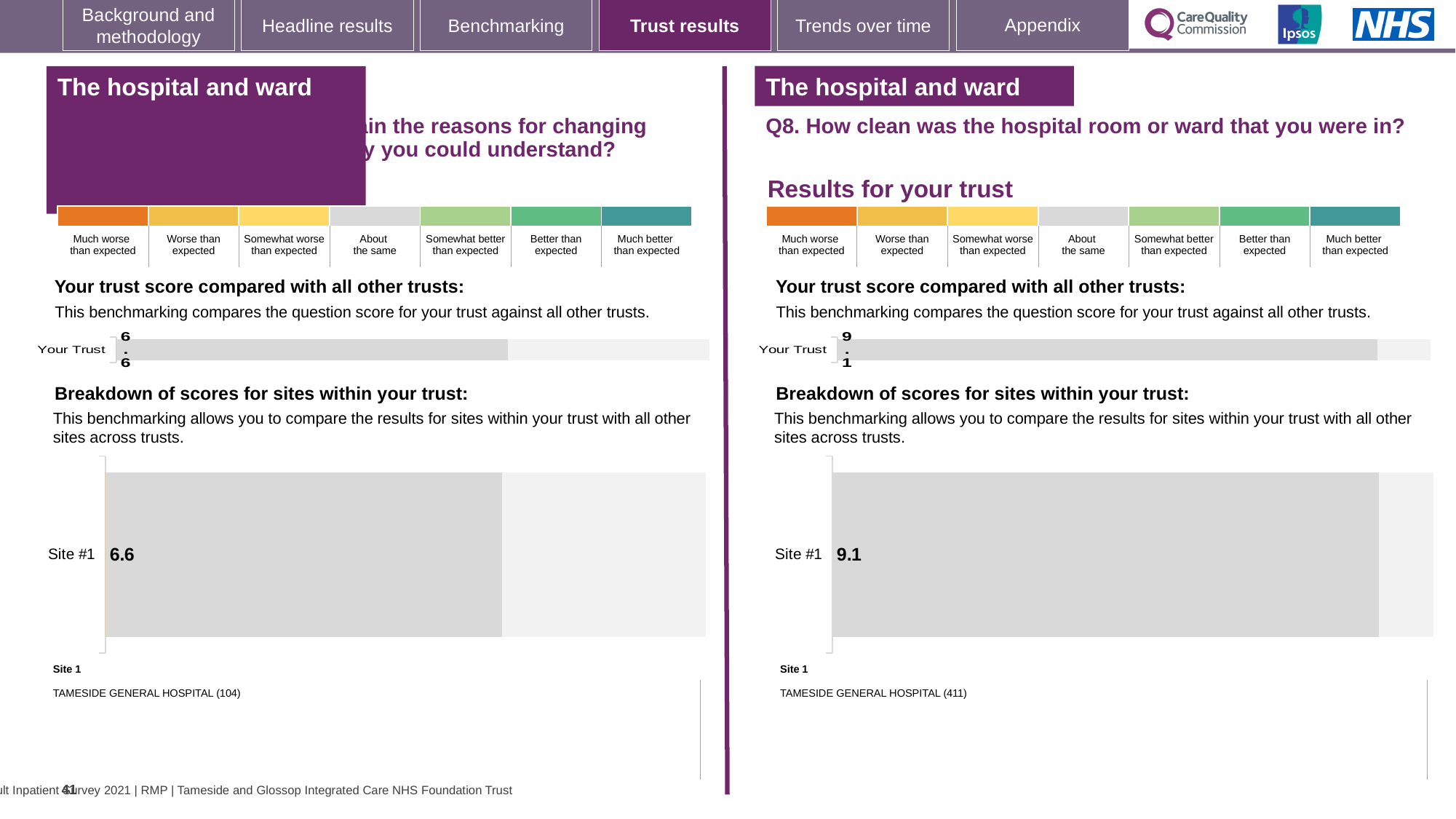
How many sites are shown in the breakdown of scores chart on the left-hand side of the slide? 1 What is the difference between the Site #1 score on the right-hand side (Q8) and the Site #1 score on the left-hand side of the slide? 2.5 On the left-hand side of the slide, which site name is listed as Site 1 below the breakdown chart? TAMESIDE GENERAL HOSPITAL (104) On the left-hand side of the slide, what is the score shown for Your Trust? 6.6 On the right-hand side of the slide (Q8), is the Site #1 score the same as the Your Trust score? Yes What type of chart is used to show the Site #1 score on the right-hand side of the slide? Bar chart On the right-hand side of the slide, which site name is listed as Site 1 below the breakdown chart? TAMESIDE GENERAL HOSPITAL (411) How many sites are shown in the breakdown of scores chart on the right-hand side of the slide (Q8)? 1 On the left-hand side of the slide, what score is shown for Site #1 in the breakdown of scores for sites within your trust? 6.6 Which is larger: the Your Trust score on the left-hand side of the slide or the Your Trust score on the right-hand side (Q8)? Right-hand side (Q8) On the right-hand side of the slide (Q8, how clean was the hospital room or ward), what is the score shown for Your Trust? 9.1 On the right-hand side of the slide (Q8), what score is shown for Site #1 in the breakdown of scores for sites within your trust? 9.1